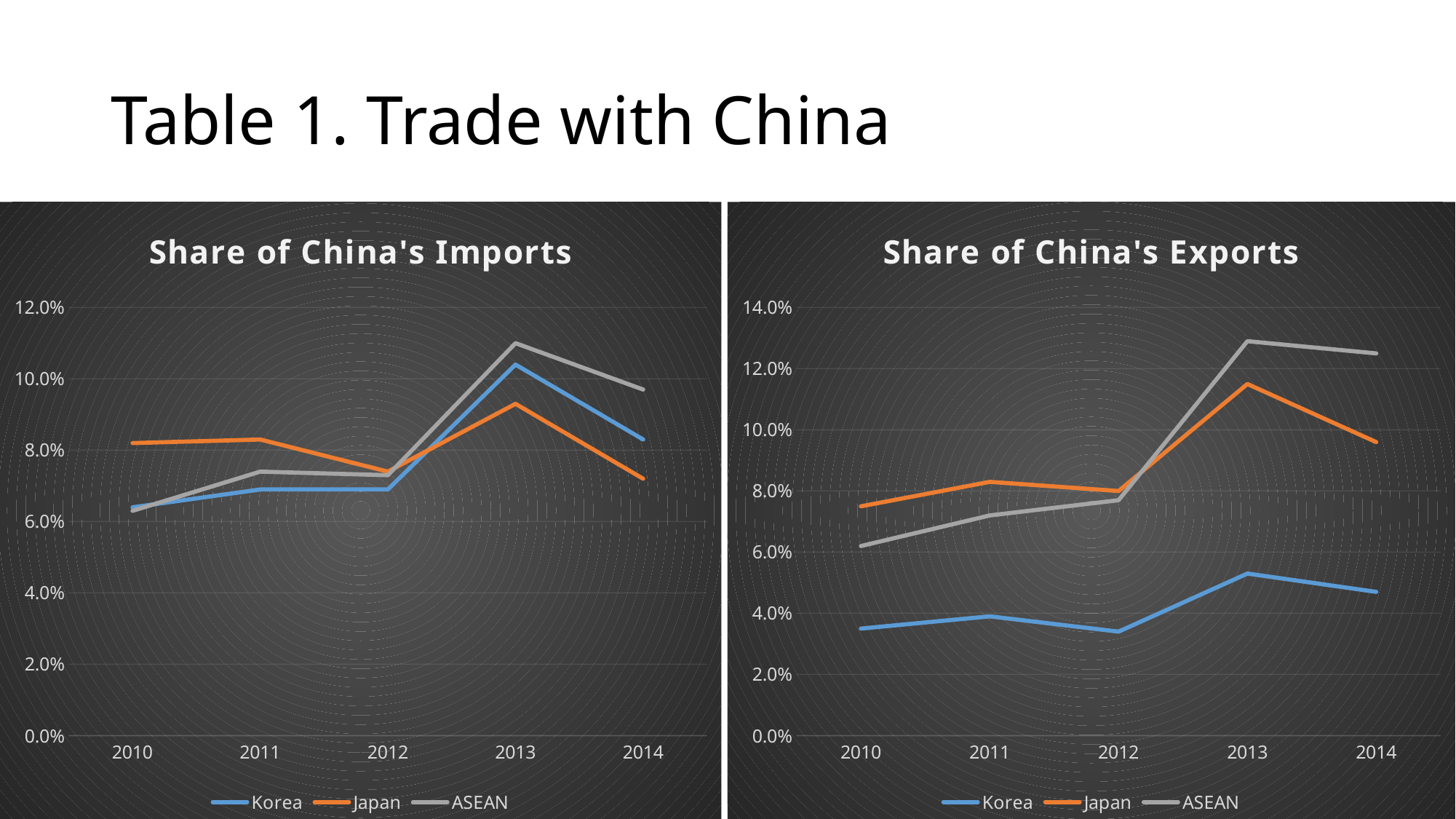
What kind of chart is the "Share of China's Imports" chart? Line chart In the "Share of China's Exports" chart, does the Korea line rise or fall from 2012 to 2013? Rise In the "Share of China's Exports" chart, is the value for ASEAN in 2013 greater or less than 12.0%? greater In the "Share of China's Imports" chart, which series has the highest value in 2013? ASEAN In the "Share of China's Imports" chart, what colour is the Japan line? Orange In the "Share of China's Exports" chart, which series has the lowest value in 2014? Korea How many series does the legend of the "Share of China's Exports" chart list? 3 In the "Share of China's Exports" chart, which is larger in 2010, Japan or ASEAN? Japan In the "Share of China's Imports" chart, is the value for ASEAN in 2013 greater or less than 10.0%? greater In the "Share of China's Exports" chart, is the value for Korea in 2010 greater or less than 4.0%? less How many years are shown on the x axis of the "Share of China's Imports" chart? 5